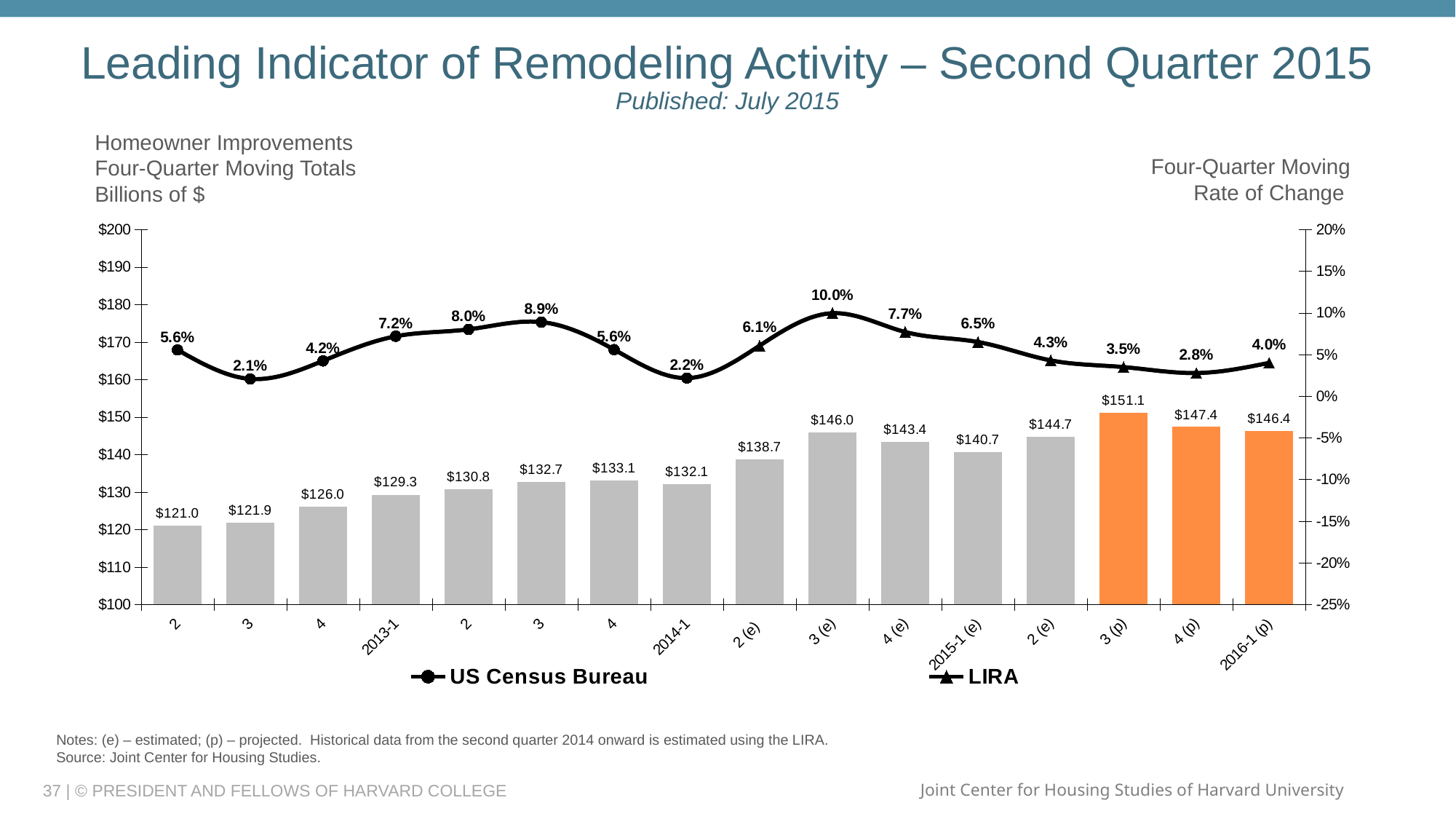
What is the four-quarter moving total for 3 (p)? $151.1 What is the four-quarter moving total for 2014-1? $132.1 Which category has the lowest four-quarter moving rate of change? 3 (the second bar, 2.1%) Which category has the highest four-quarter moving total bar? 3 (p) What are the two series named in the legend? US Census Bureau and LIRA How many bars are plotted on the chart? 16 What is the difference between the four-quarter moving totals for 3 (p) and 2016-1 (p)? $4.7 Does the four-quarter moving rate of change rise or fall from 3 (e) to 4 (p)? Fall Which is larger, the four-quarter moving total for 4 (e) or for 2015-1 (e)? 4 (e) What kinds of chart are combined on this slide? Bar chart and line chart What is the four-quarter moving rate of change for 3 (e)? 10.0% How many series does the legend list? 2